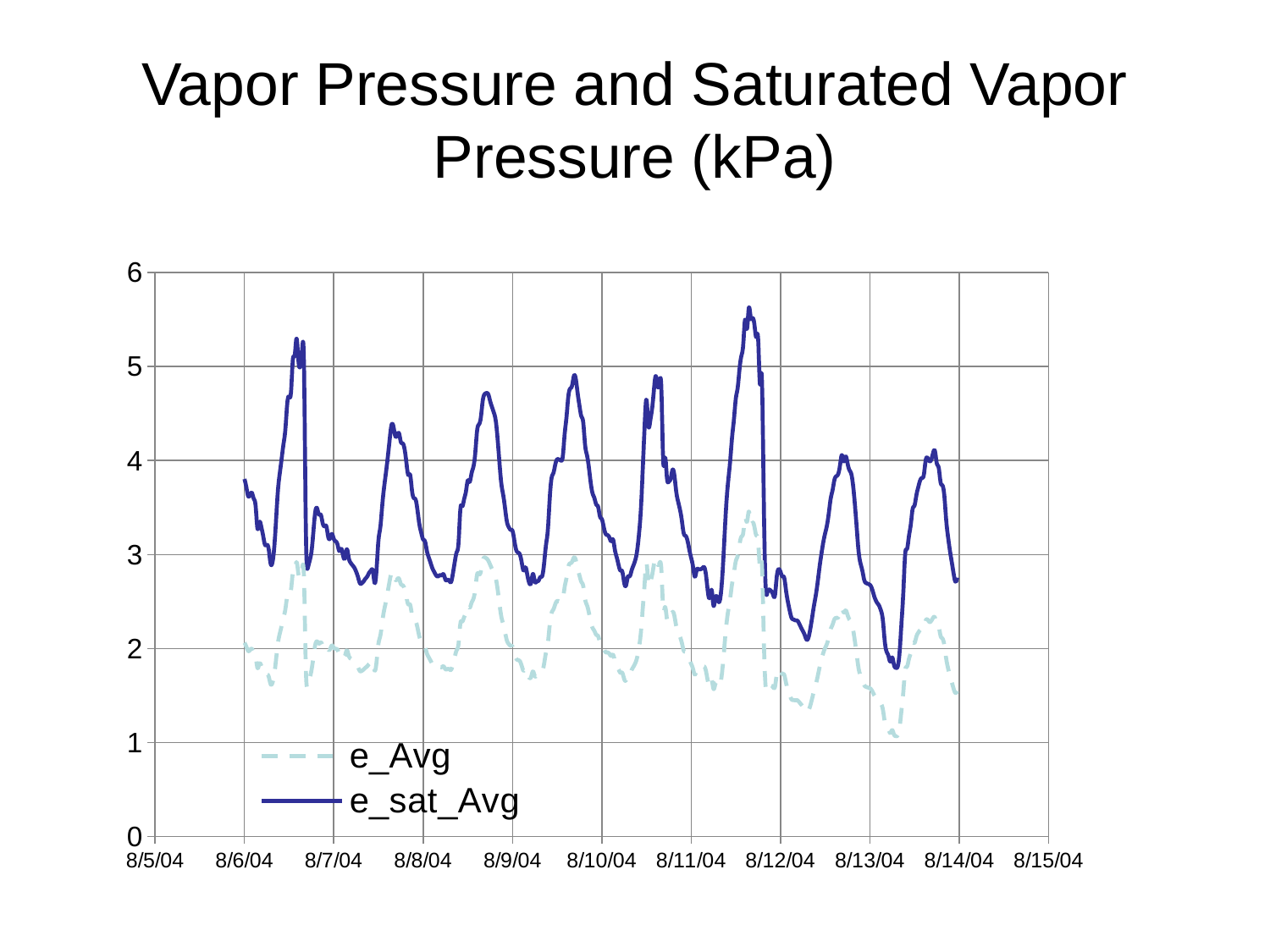
Is the lowest value of e_Avg greater or less than 1.5? less What are the two series named in the legend? e_Avg and e_sat_Avg Which series has the higher values throughout the chart, e_Avg or e_sat_Avg? e_sat_Avg Is the highest peak of e_Avg greater or less than 3? greater Which series is drawn as a dashed line? e_Avg Between which two x-axis dates does e_Avg reach its lowest value? 8/13/04 and 8/14/04 Is the highest peak of e_sat_Avg greater or less than 5? greater How many series does the legend list? 2 Between which two x-axis dates does e_sat_Avg reach its highest peak? 8/11/04 and 8/12/04 How many date labels are shown on the x axis? 11 What kind of chart is shown on the slide? line chart